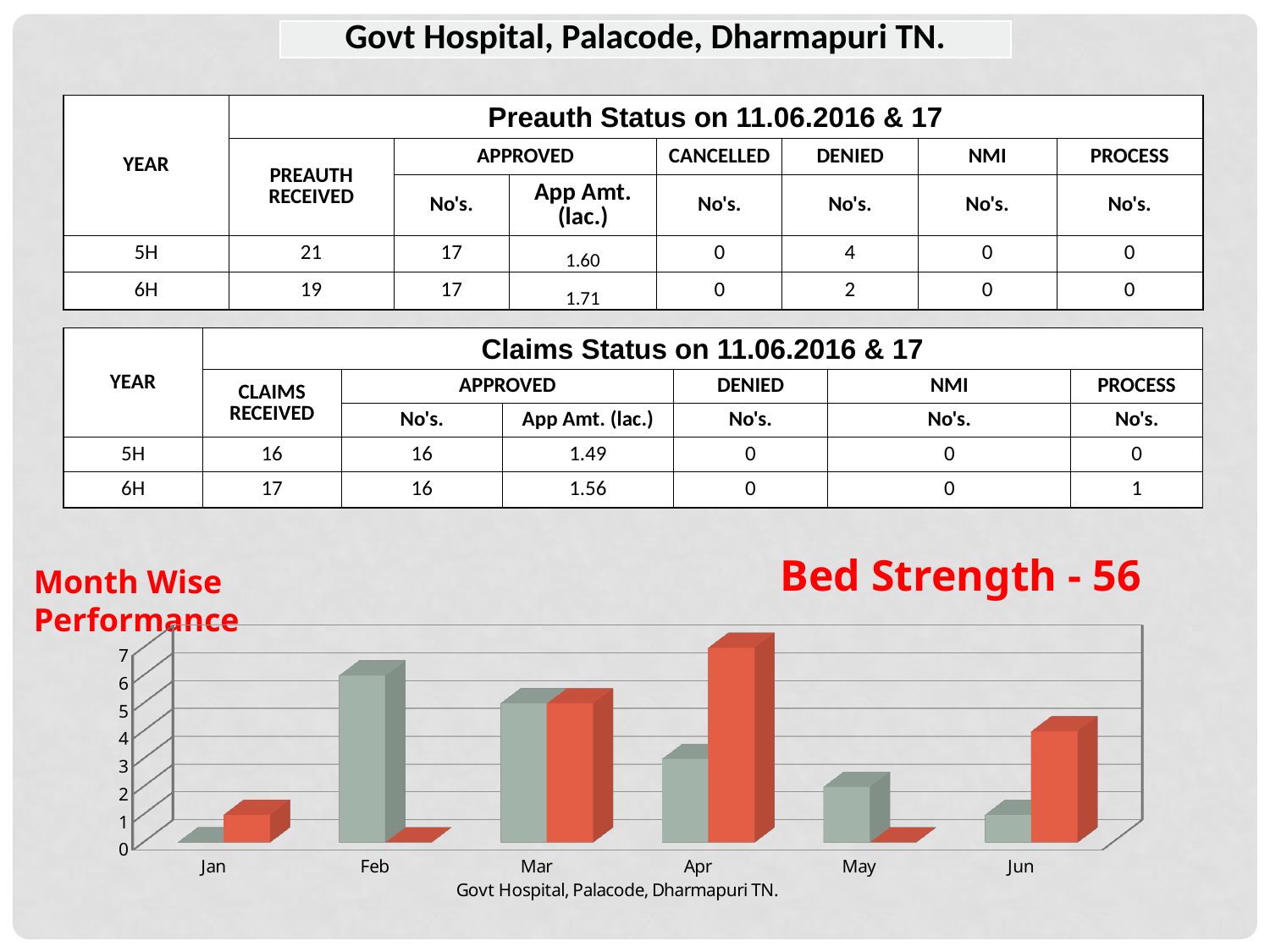
In the Month Wise Performance chart, which is larger for Feb, the grey bar or the red bar? the grey bar How many months are shown on the x axis of the Month Wise Performance chart? 6 In the Month Wise Performance chart, which month has the tallest grey bar? Feb In the Month Wise Performance chart, do the grey bars rise or fall from Feb to Jun? fall In the Month Wise Performance chart, which month has the tallest red bar? Apr In the Month Wise Performance chart, is the grey bar for May greater or less than 4? less In the Month Wise Performance chart, which is larger for Apr, the grey bar or the red bar? the red bar In the Month Wise Performance chart, is the red bar for Jan greater or less than 3? less What text appears below the x axis of the Month Wise Performance chart? Govt Hospital, Palacode, Dharmapuri TN. In the Month Wise Performance chart, is the grey bar for Feb greater or less than 4? greater What kind of chart is shown under the heading "Month Wise Performance"? bar chart